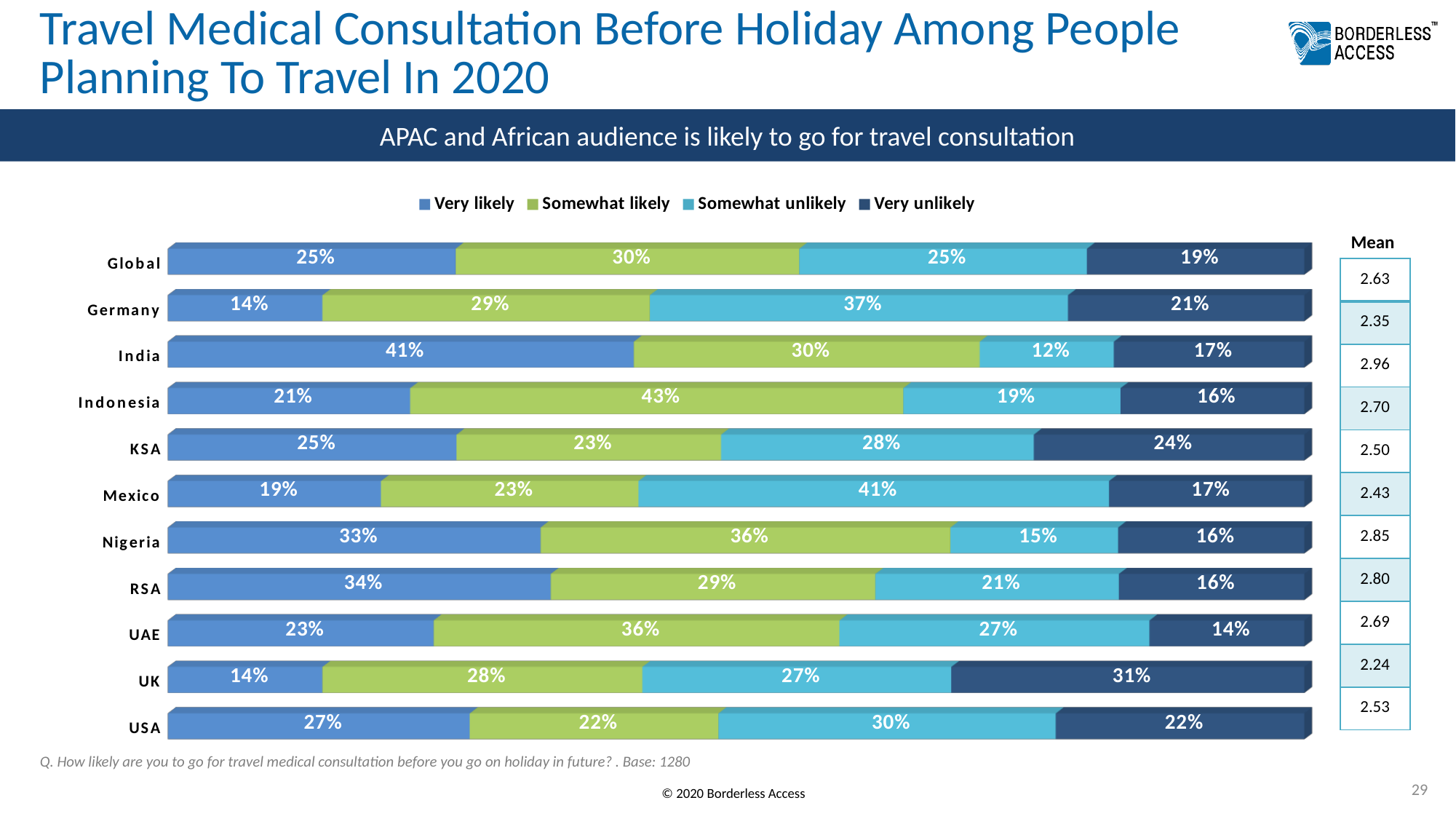
What is the 'Somewhat likely' value for Indonesia? 43% What is the 'Very unlikely' value for the UK? 31% Which country has the highest 'Very likely' percentage? India What is the Mean value shown for Germany? 2.35 What percentage of respondents in India are 'Very likely' to go for travel medical consultation? 41% Which country has the lowest 'Very unlikely' percentage? UAE How many categories (rows) are shown in the chart? 11 What kind of chart is shown on the slide? Stacked bar chart Which is larger, the 'Very likely' value for Nigeria or for RSA? RSA Which legend entry is shown in green? Somewhat likely What is the difference between the 'Somewhat unlikely' values for Mexico and India? 29% How many series does the legend list? 4